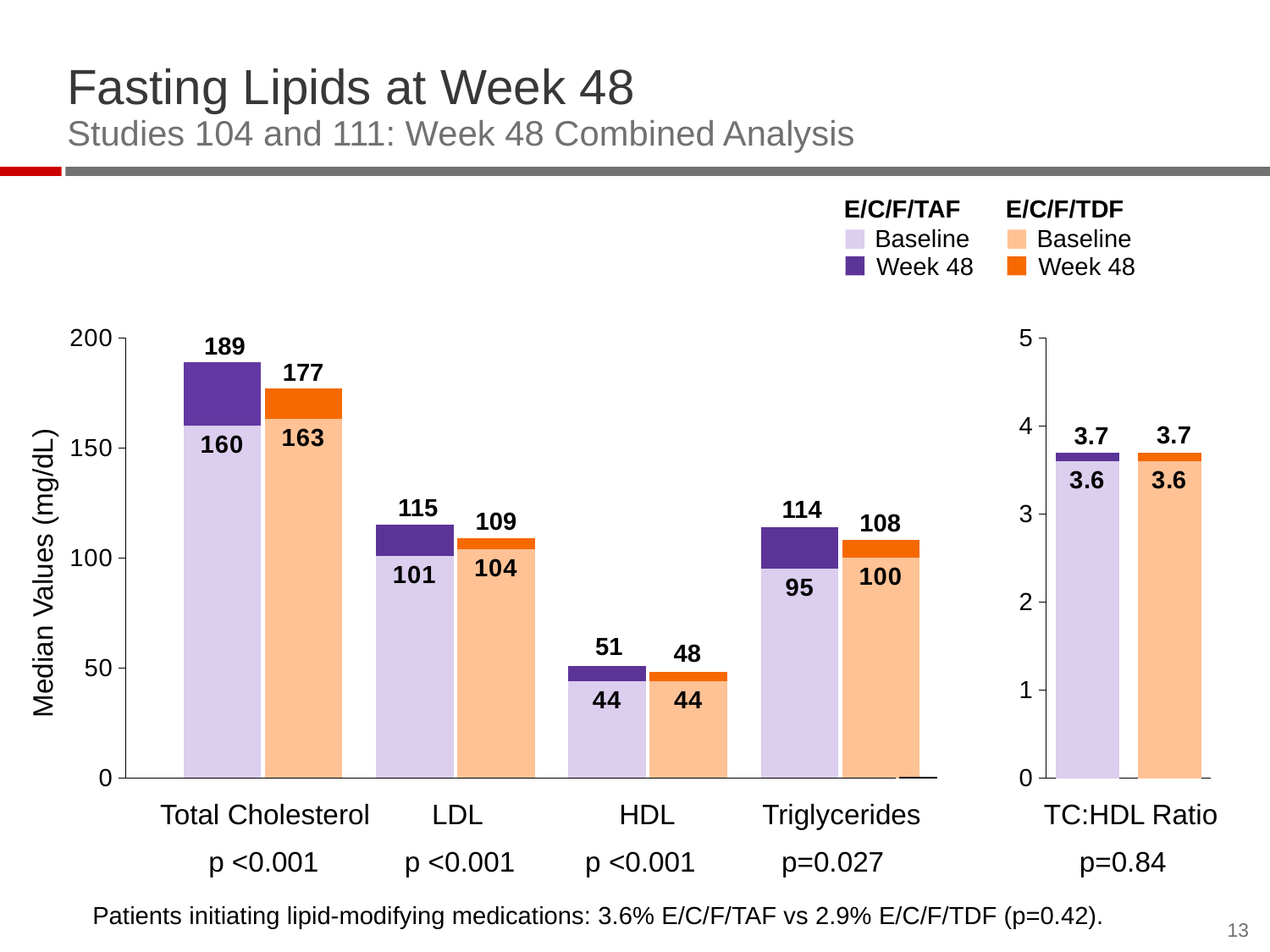
On the left chart, by how much did the median Total Cholesterol for E/C/F/TAF increase from baseline to Week 48? 29 On the right chart, what is the Week 48 TC:HDL Ratio for E/C/F/TDF? 3.7 On the left chart, what is the baseline median LDL value for E/C/F/TDF? 104 On the left chart, what is the baseline median HDL value for E/C/F/TAF? 44 On the left chart, what is the Week 48 median Total Cholesterol value for E/C/F/TAF? 189 How many lipid categories are shown on the left chart? 4 On the left chart, which lipid category has the highest Week 48 median value for E/C/F/TAF? Total Cholesterol On the left chart, which arm has the higher Week 48 median LDL value, E/C/F/TAF or E/C/F/TDF? E/C/F/TAF On the left chart, what is the Week 48 median Triglycerides value for E/C/F/TDF? 108 What is the y-axis label of the left chart? Median Values (mg/dL) How many series does the legend list in total? 4 On the left chart, which lipid category has the lowest baseline median value? HDL